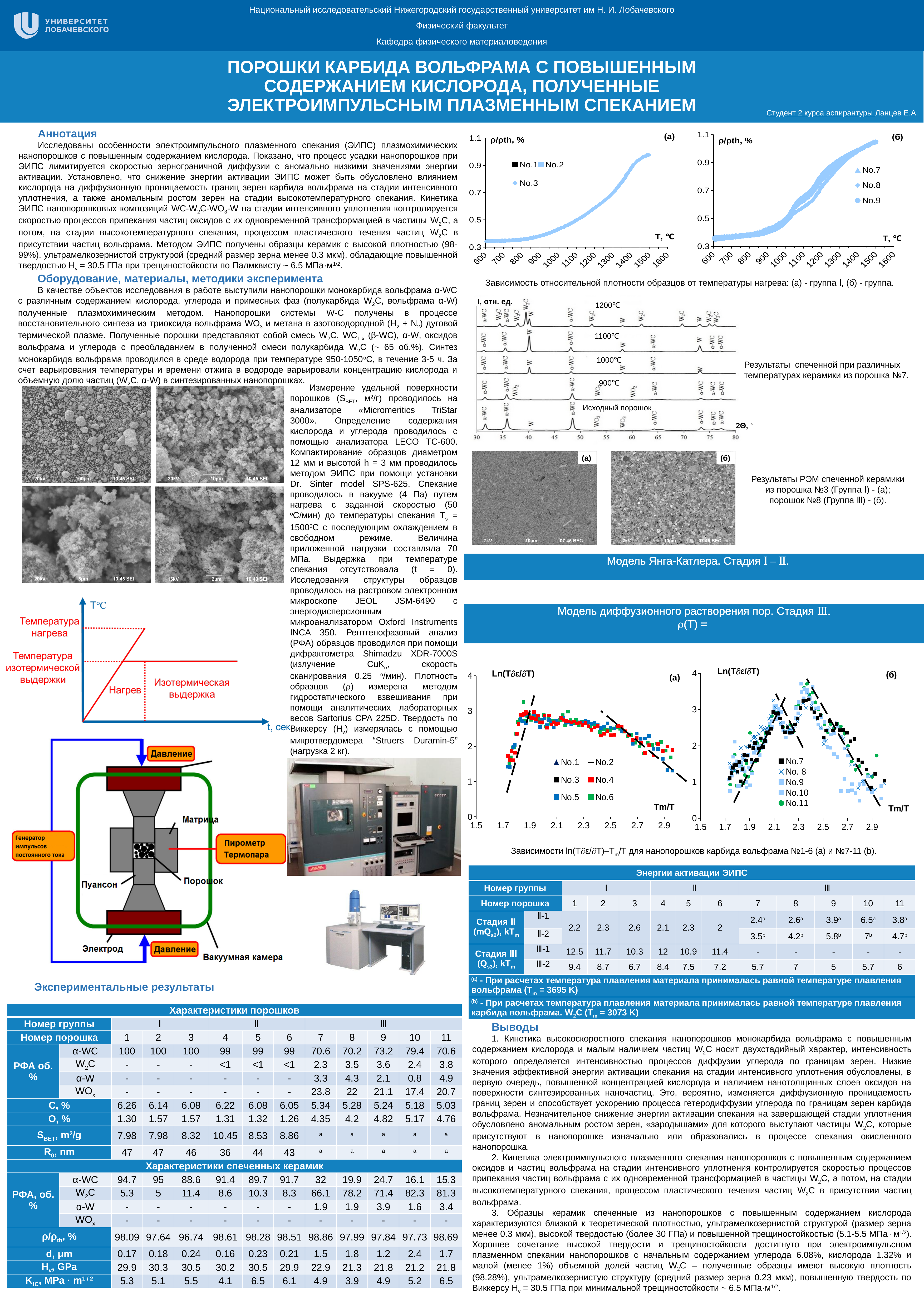
In the Ln(T∂ε/∂T) versus Tm/T chart labelled (б), how many series does the legend list? 5 In the top-right density chart labelled (а), is the value at 600 °C greater or less than 0.5? less In the Ln(T∂ε/∂T) versus Tm/T chart labelled (а), how many series does the legend list? 6 What is the x-axis label of the top-right density charts (а) and (б)? T, °C What kind of chart is the Ln(T∂ε/∂T) versus Tm/T chart labelled (а)? scatter chart In the top-right density chart labelled (а), how many series does the legend list? 3 In the top-right density chart labelled (б), which series are listed in the legend? No.7, No.8, No.9 In the top-right density chart labelled (б), is the value at 1500 °C greater or less than 0.9? greater In the Ln(T∂ε/∂T) versus Tm/T chart labelled (б), what is the highest value shown on the y axis? 4 In the top-right density chart labelled (а), do the values rise or fall as temperature T increases along the x axis? rise